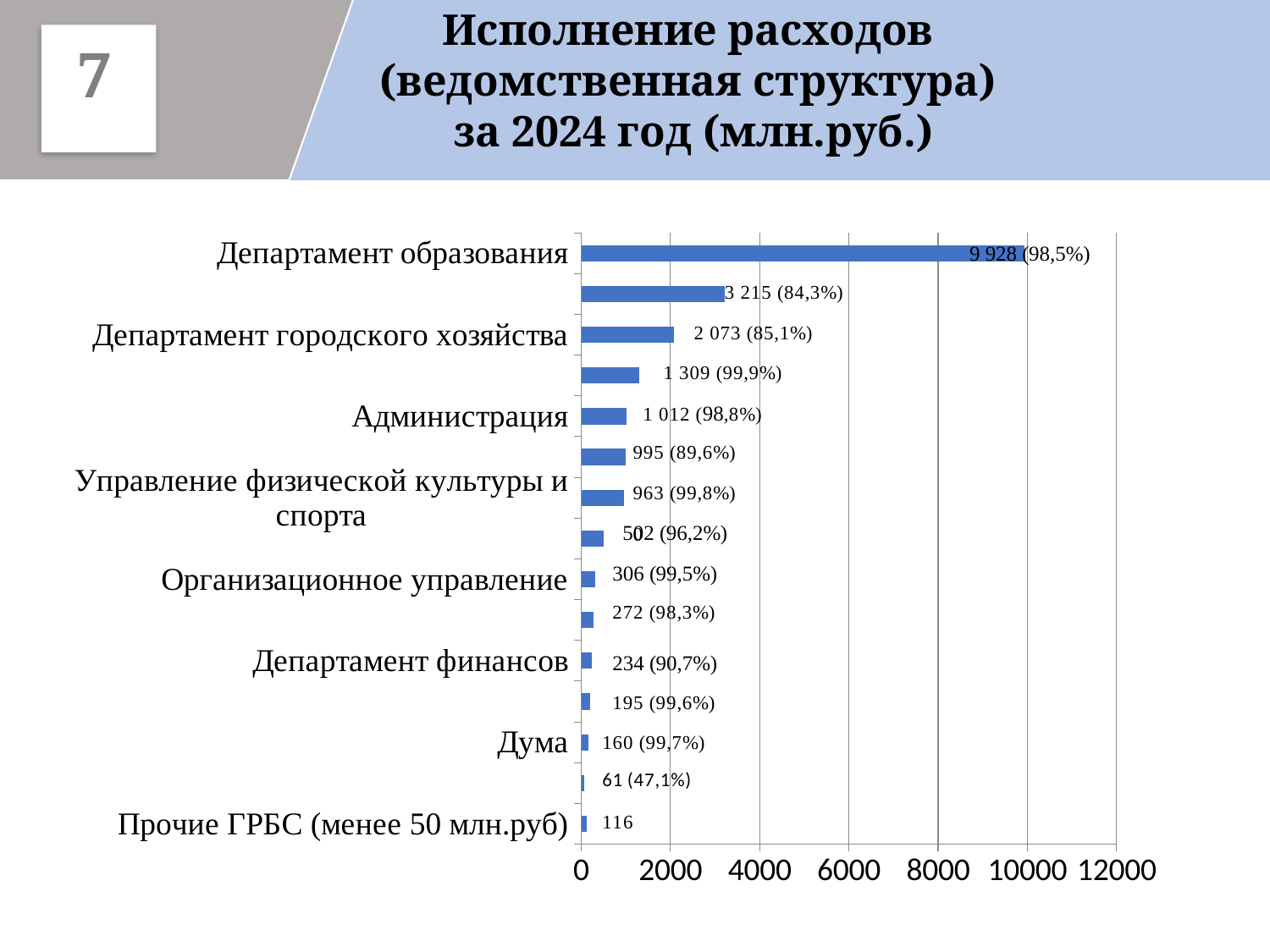
What value is labeled on the bar for Администрация? 1 012 (98,8%) What type of chart is shown on the slide? bar chart What value is labeled on the bar for Департамент городского хозяйства? 2 073 (85,1%) What value is labeled on the bar for Дума? 160 (99,7%) What is the title of the chart on the slide? Исполнение расходов (ведомственная структура) за 2024 год (млн.руб.) What is the difference in млн.руб. between Департамент образования (9 928) and Департамент городского хозяйства (2 073)? 7 855 Which has a larger value, Администрация or Департамент финансов? Администрация What value is labeled on the bar for Департамент образования? 9 928 (98,5%) Which category has the highest value on the chart? Департамент образования Is the value for Департамент образования greater or less than 8000? greater What value is labeled on the bar for Прочие ГРБС (менее 50 млн.руб)? 116 How many bars are plotted on the chart? 15